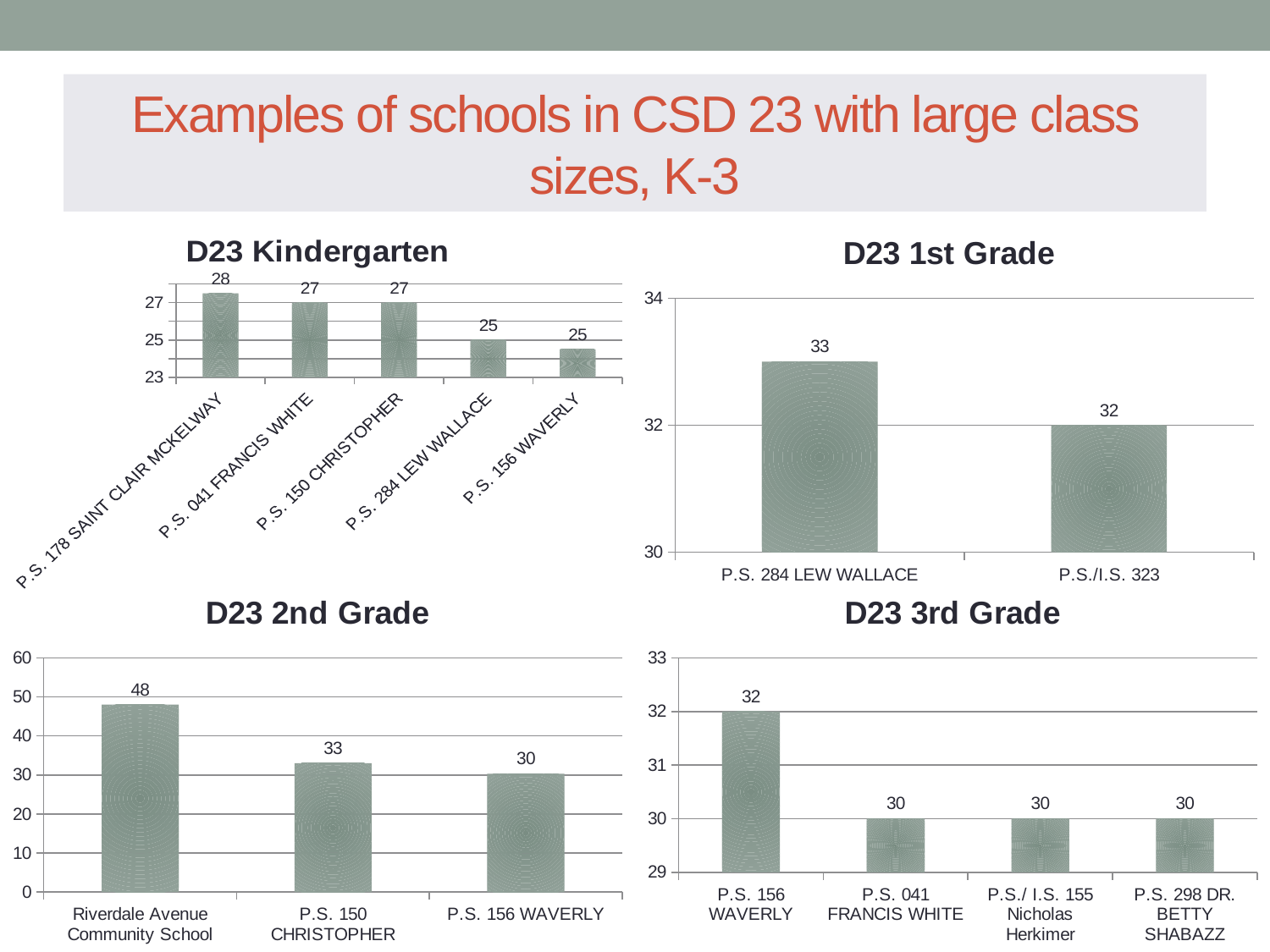
In the D23 3rd Grade chart, what is the value for P.S. 156 WAVERLY? 32 In the D23 1st Grade chart, what is the value for P.S./I.S. 323? 32 In the D23 2nd Grade chart, which school has the lowest value? P.S. 156 WAVERLY In the D23 Kindergarten chart, which school has the highest value? P.S. 178 SAINT CLAIR MCKELWAY How many schools are shown in the D23 Kindergarten chart? 5 In the D23 2nd Grade chart, what is the value for Riverdale Avenue Community School? 48 What kind of chart is the D23 2nd Grade chart? Bar chart In the D23 Kindergarten chart, what is the value for P.S. 178 SAINT CLAIR MCKELWAY? 28 In the D23 3rd Grade chart, which is larger, P.S. 156 WAVERLY or P.S. 298 DR. BETTY SHABAZZ? P.S. 156 WAVERLY How many schools are shown in the D23 3rd Grade chart? 4 In the D23 1st Grade chart, what is the difference between P.S. 284 LEW WALLACE and P.S./I.S. 323? 1 In the D23 2nd Grade chart, what is the difference between Riverdale Avenue Community School and P.S. 150 CHRISTOPHER? 15